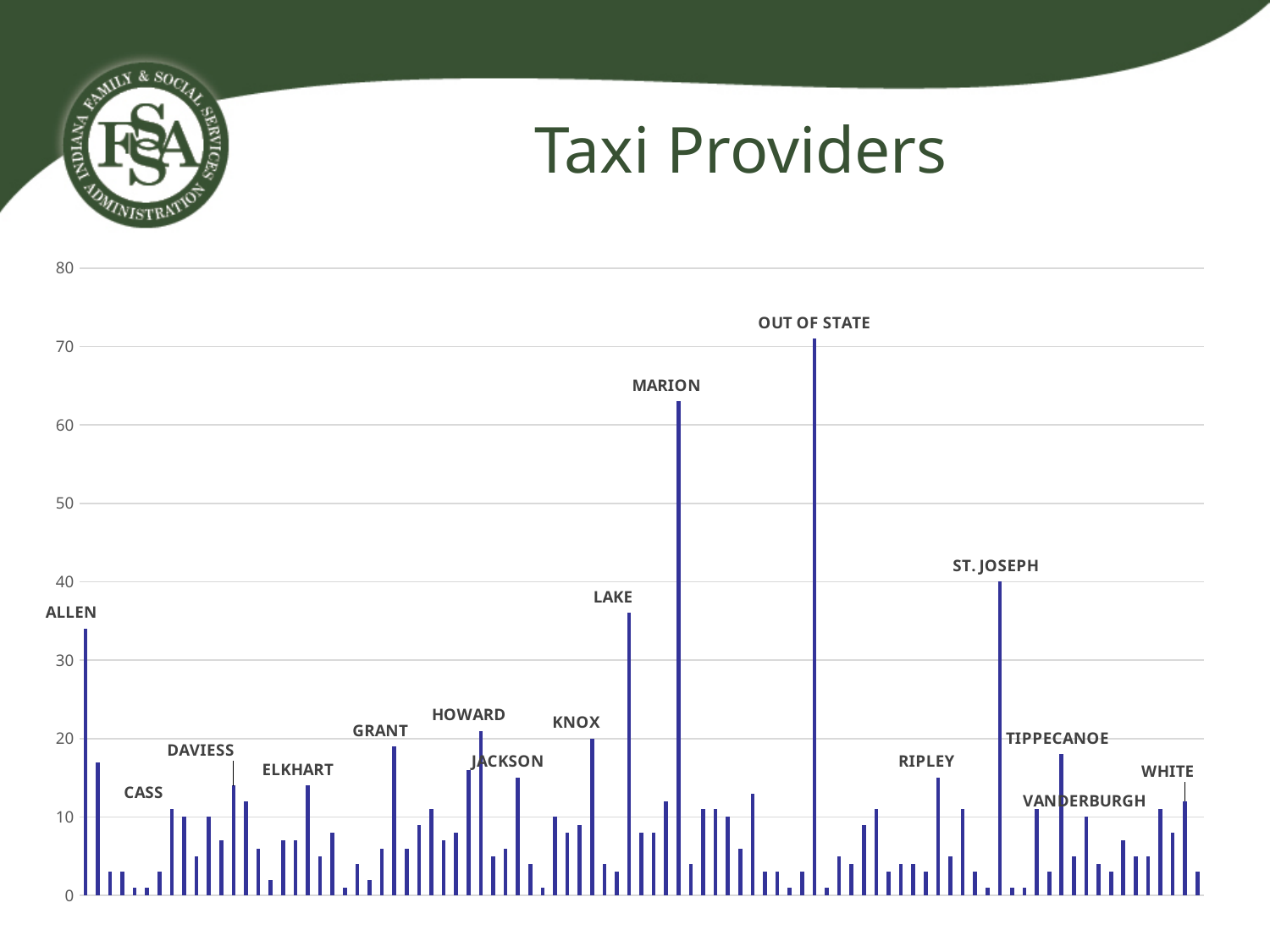
Is the value for LAKE greater or less than 40? less Which labelled category has the highest value? OUT OF STATE Which is larger, the value for MARION or the value for ST. JOSEPH? MARION Which is larger, the value for ST. JOSEPH or the value for LAKE? ST. JOSEPH Is the value for MARION greater or less than 60? greater What kind of chart is shown on the slide? bar chart Is the value for HOWARD greater or less than 10? greater What is the title of the chart? Taxi Providers Which is larger, the value for MARION or the value for OUT OF STATE? OUT OF STATE